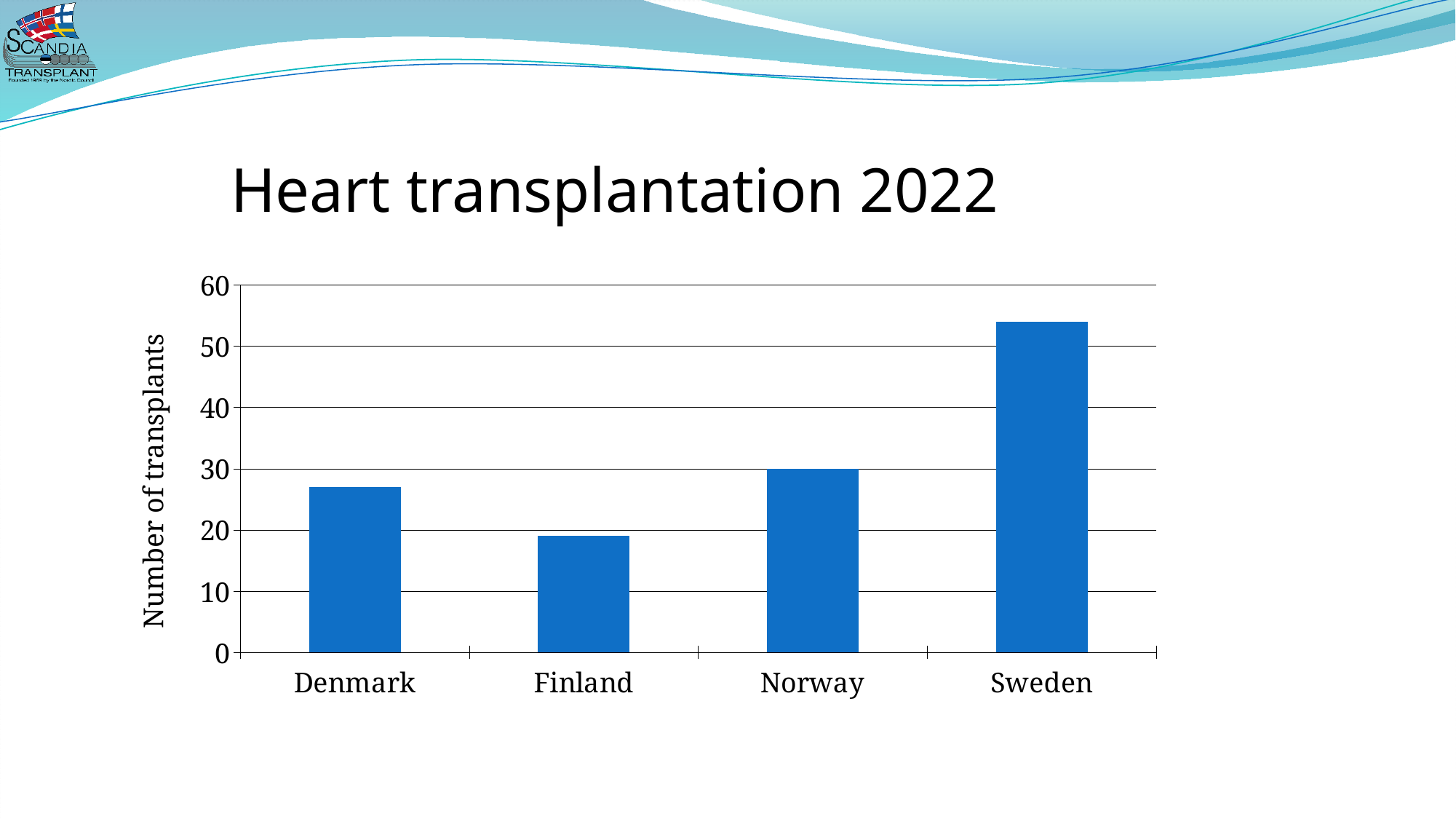
Which has more heart transplants, Norway or Sweden? Sweden What is the number of transplants for Norway? 30 What kind of chart is shown on the slide? Bar chart Which has more heart transplants, Denmark or Finland? Denmark Is the value for Denmark greater or less than 20? greater Which country has the lowest number of heart transplants? Finland Which country has the highest number of heart transplants? Sweden Is the value for Sweden greater or less than 50? greater How many countries are shown on the x axis? 4 What is the label of the vertical axis? Number of transplants What is the title of the chart on the slide? Heart transplantation 2022